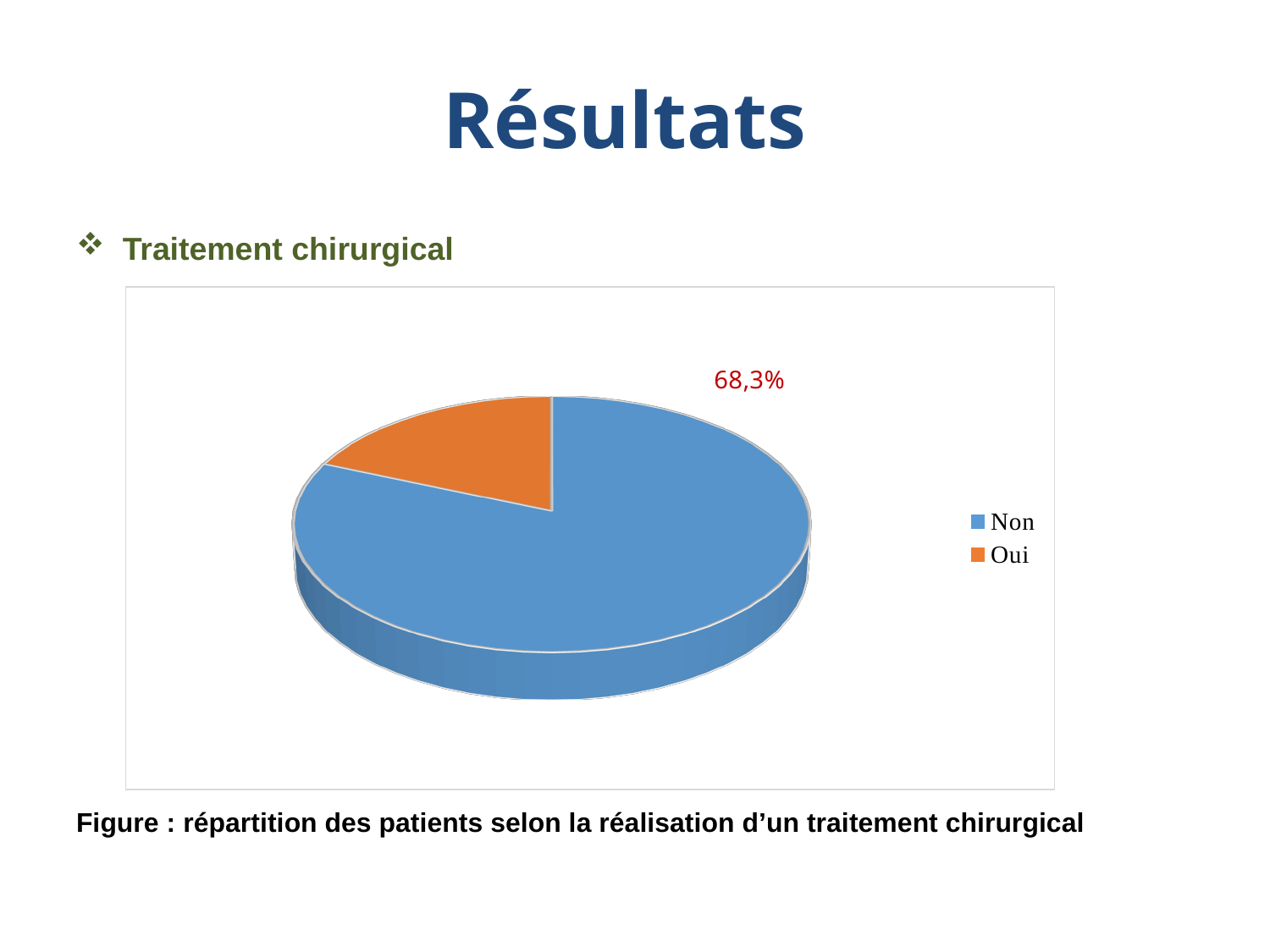
What colour is the Non slice in the pie chart? blue What percentage is labelled next to the Non slice? 68,3% Which category has the smallest slice of the pie chart? Oui How many entries does the legend of the pie chart list? 2 What percentage value is printed on the pie chart? 68,3% Which slice is larger, Non or Oui? Non What colour is the Oui slice in the pie chart? orange Which category has the largest slice of the pie chart? Non How many slices does the pie chart have? 2 What kind of chart is shown on the slide? pie chart